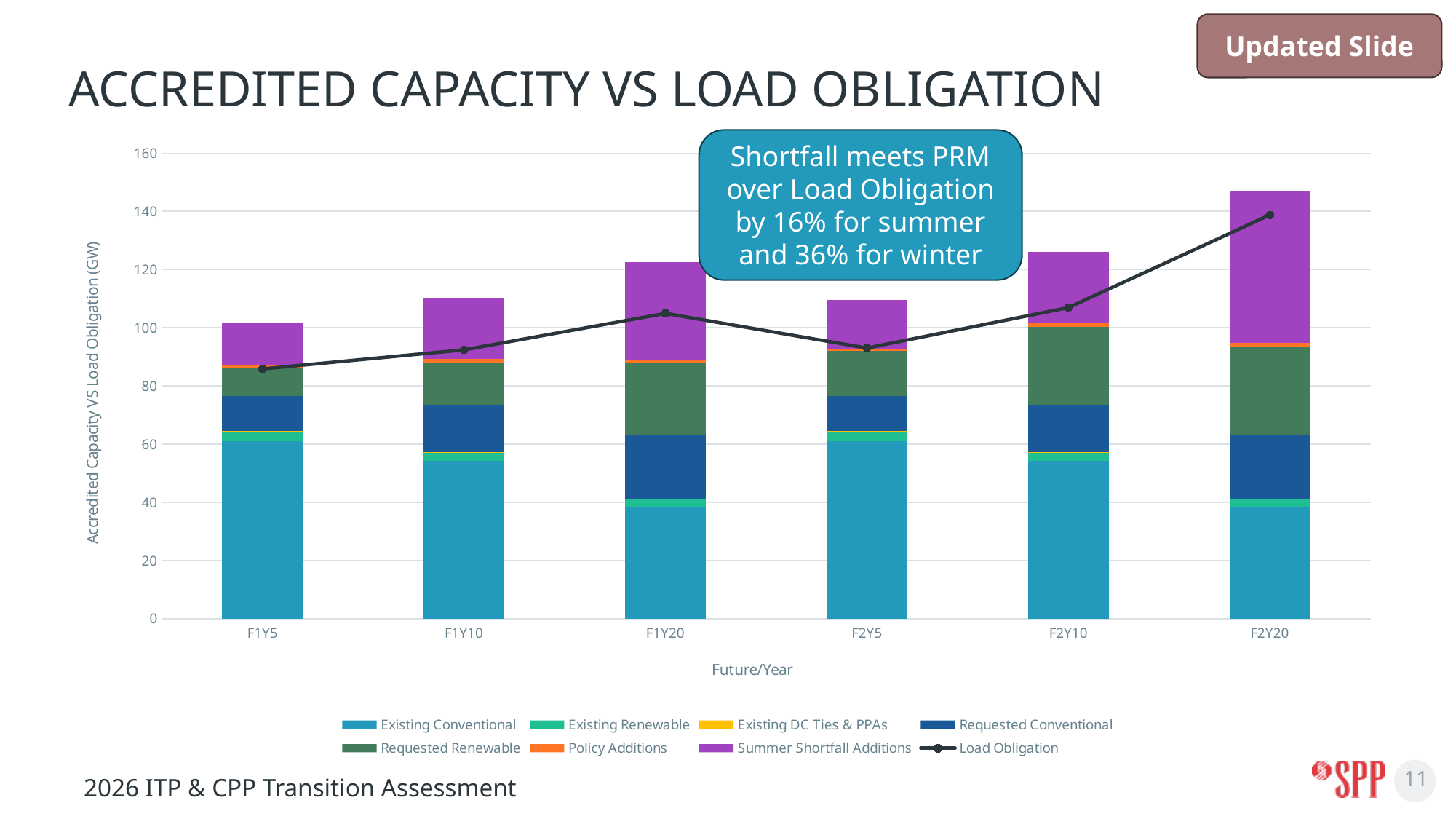
Is the total stacked bar for F2Y20 greater or less than 140? greater Which has the taller stacked bar, F1Y20 or F2Y5? F1Y20 Is the total stacked bar for F2Y10 greater or less than 120? greater Which Future/Year has the shortest stacked bar? F1Y5 Which has the higher Load Obligation, F1Y20 or F2Y5? F1Y20 What kind of chart is shown on the slide? Stacked bar chart with a line Which Future/Year has the tallest stacked bar? F2Y20 How many Future/Year categories are shown on the x axis? 6 How many series does the legend list? 8 What is the label of the y axis? Accredited Capacity VS Load Obligation (GW) Is the Load Obligation value for F1Y5 greater or less than 100? less